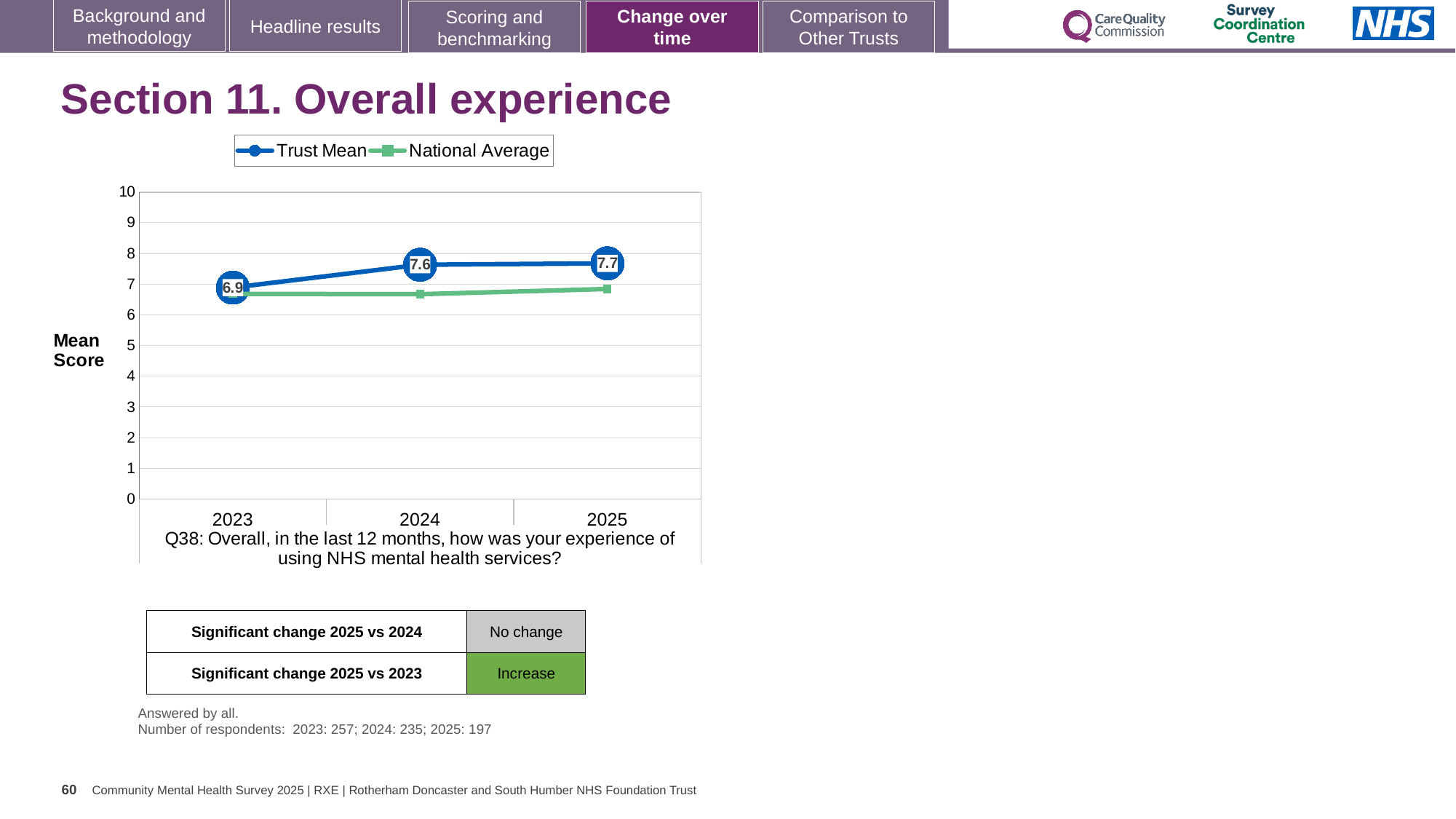
What is the Trust Mean score for 2024? 7.6 What is the Trust Mean score for 2023? 6.9 In which year is the Trust Mean score highest? 2025 Which is larger, the Trust Mean score in 2024 or in 2023? 2024 What is the difference between the Trust Mean score in 2025 and in 2023? 0.8 What is the Trust Mean score for 2025? 7.7 Is the National Average value for 2025 greater or less than 7? less What kind of chart is shown on the slide? line chart How many series does the chart legend list? 2 How many years are shown on the x axis of the chart? 3 Does the Trust Mean score rise or fall from 2023 to 2025? rise In which year is the Trust Mean score lowest? 2023